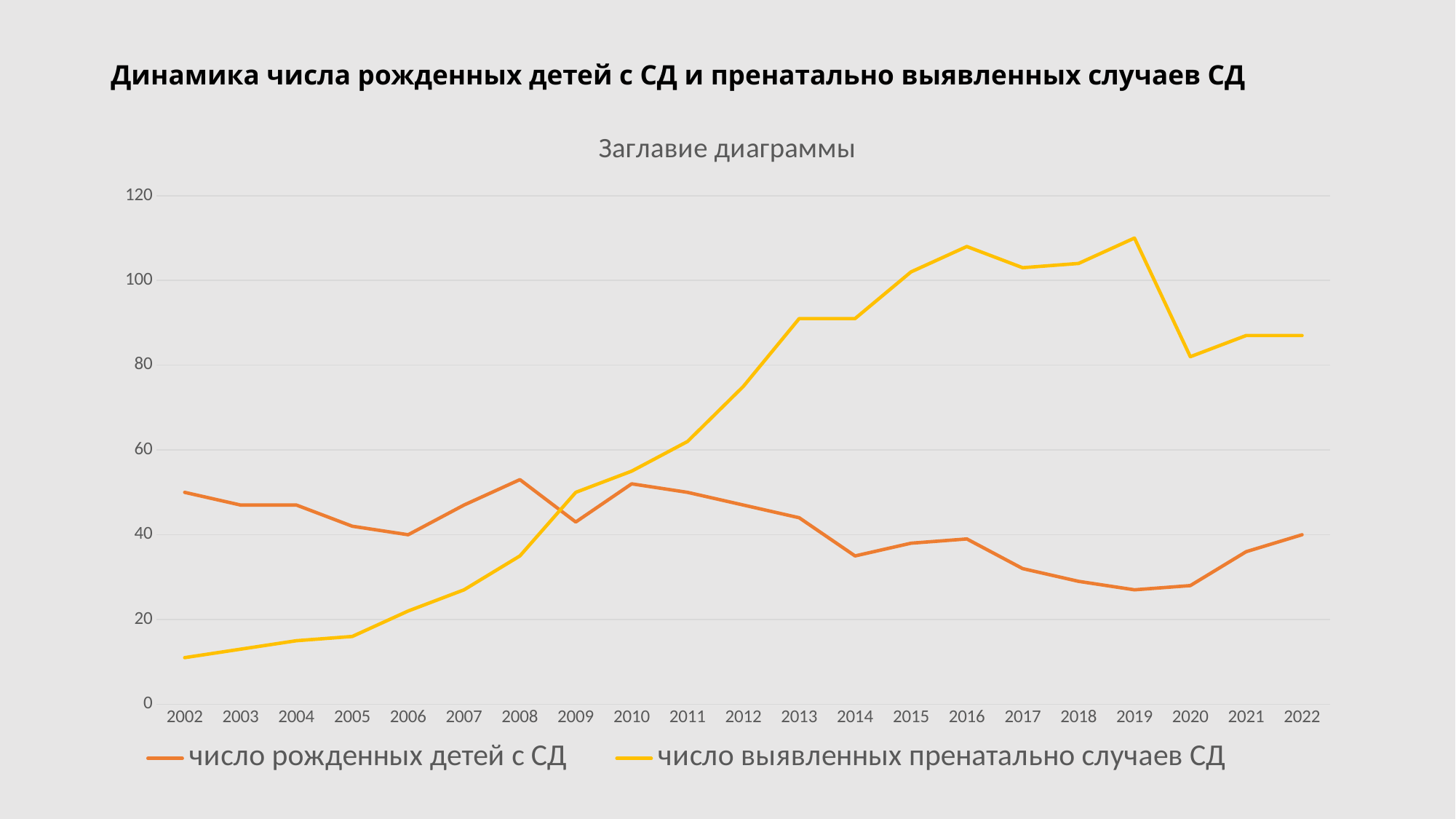
How many series does the legend list? 2 In 2022, which series has the larger value: 'число рожденных детей с СД' or 'число выявленных пренатально случаев СД'? число выявленных пренатально случаев СД Is the value for 'число выявленных пренатально случаев СД' in 2002 greater or less than 20? less In which year is the series 'число выявленных пренатально случаев СД' at its lowest? 2002 How many years are shown along the x axis? 21 Does the series 'число выявленных пренатально случаев СД' generally rise or fall from 2002 to 2019? rise In 2002, which series has the larger value: 'число рожденных детей с СД' or 'число выявленных пренатально случаев СД'? число рожденных детей с СД Is the value for 'число рожденных детей с СД' in 2008 greater or less than 60? less Is the value for 'число рожденных детей с СД' in 2019 greater or less than 40? less What kind of chart is shown on the slide? line chart In which year does the series 'число выявленных пренатально случаев СД' reach its highest value? 2019